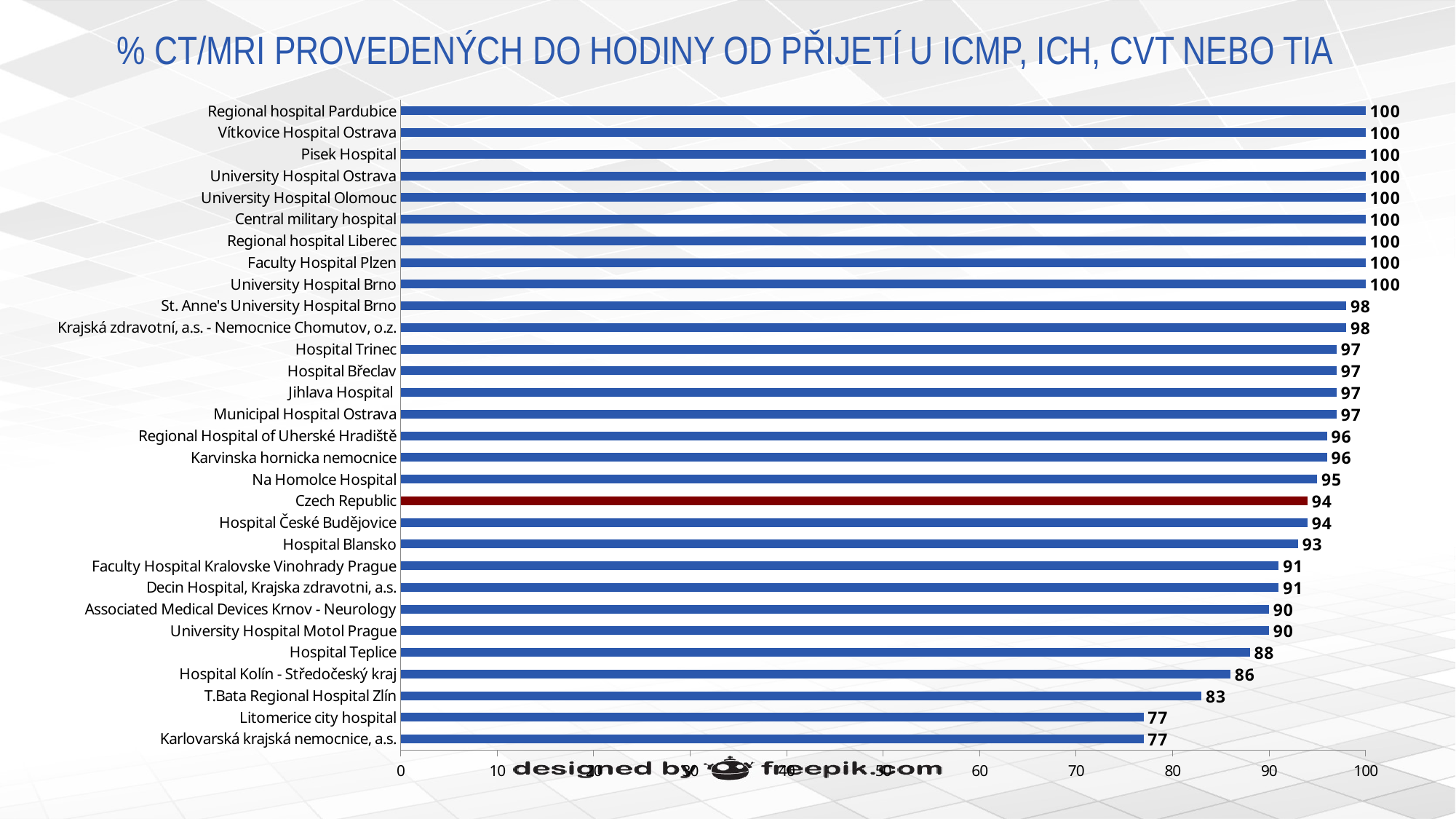
What is the value for Na Homolce Hospital? 95 Is the value for Hospital Kolín - Středočeský kraj greater or less than 90? less Which is larger, the value for Hospital Trinec or the value for University Hospital Motol Prague? Hospital Trinec What is the value for T.Bata Regional Hospital Zlín? 83 What is the difference between the values for Czech Republic and Karlovarská krajská nemocnice, a.s.? 17 Which category has the lowest value, Litomerice city hospital or Hospital Kolín - Středočeský kraj? Litomerice city hospital How many categories are shown on the chart? 30 Which category's bar is coloured dark red instead of blue? Czech Republic What is the value for Hospital Teplice? 88 What is the difference between the values for Hospital Blansko and Hospital Teplice? 5 What kind of chart is shown on the slide? bar chart What is the value for Czech Republic? 94